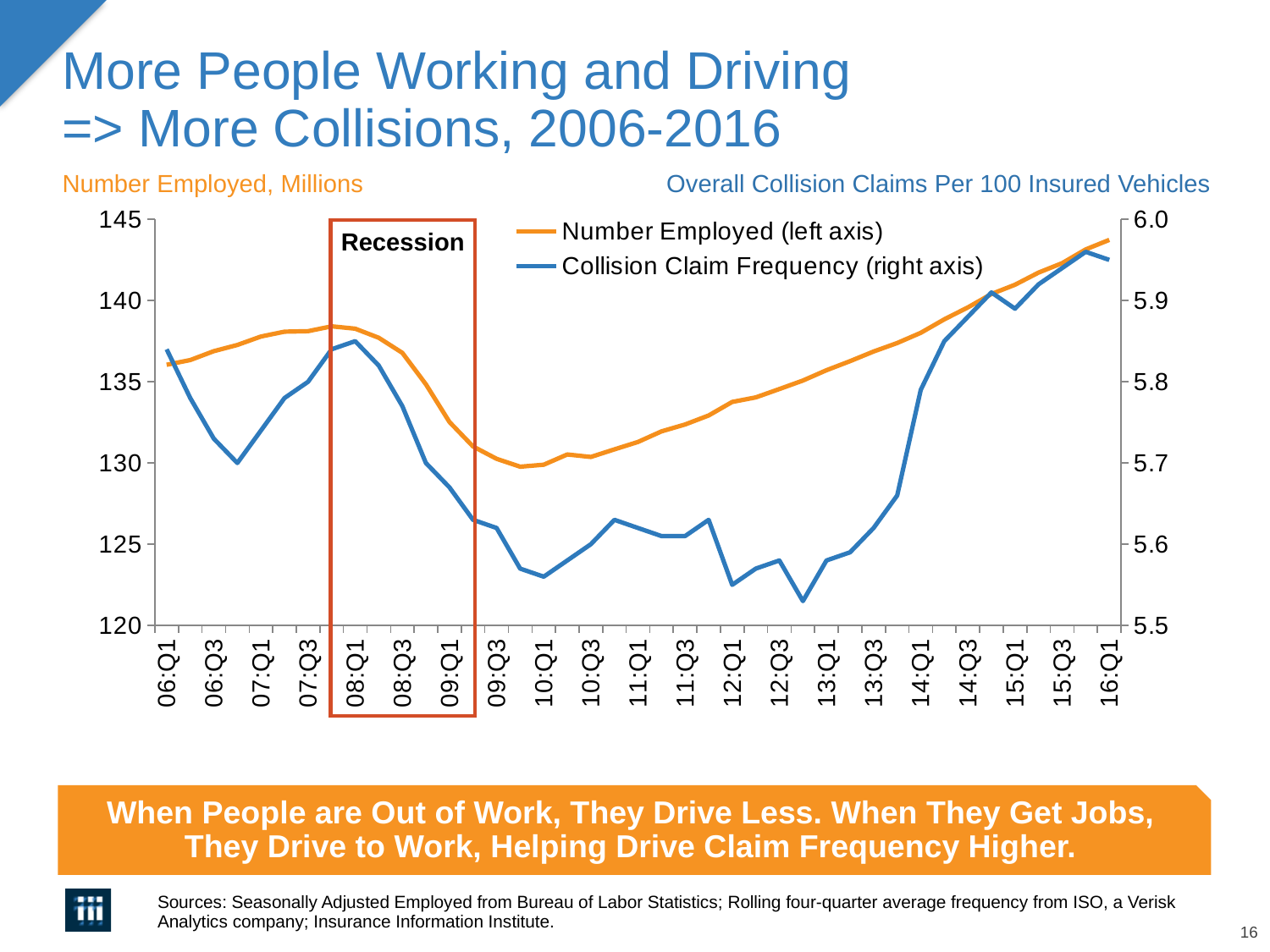
Is the value for Collision Claim Frequency at 16:Q1 greater or less than 5.9? greater What kind of chart is shown on the slide? Line chart What period is marked by the red box on the chart? Recession Is Collision Claim Frequency higher at 14:Q1 or at 12:Q1? 14:Q1 Which series is plotted against the right axis? Collision Claim Frequency Is Number Employed higher at 16:Q1 or at 06:Q1? 16:Q1 Is the value for Number Employed at 16:Q1 greater or less than 140? greater At which labeled quarter does Number Employed reach its highest value? 16:Q1 How many series does the chart legend list? 2 Is the value for Number Employed at 10:Q1 greater or less than 135? less Does Number Employed rise or fall from 10:Q1 to 16:Q1? Rise